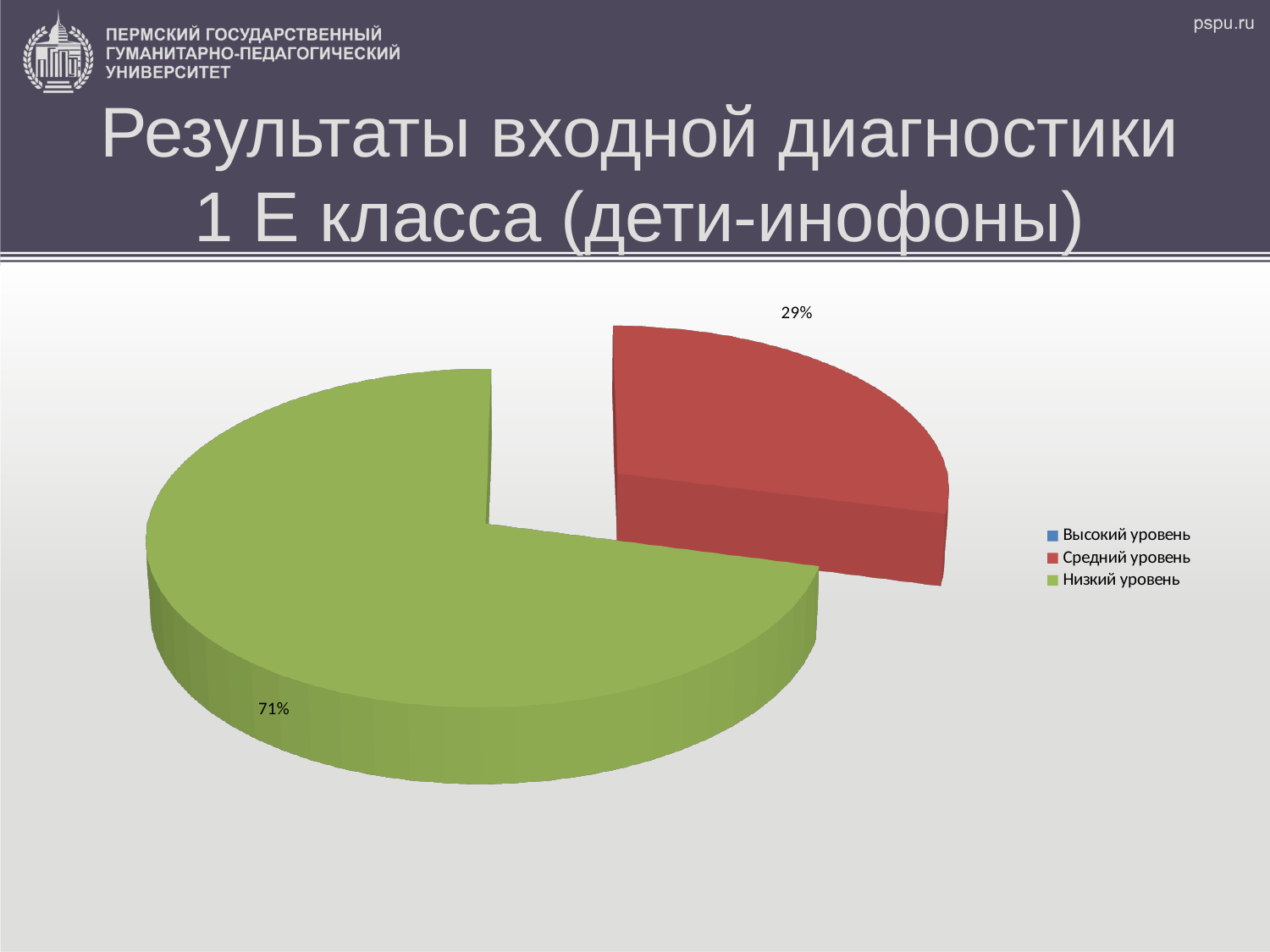
What colour is the slice for Низкий уровень? green What colour is the slice for Средний уровень? red Is the share for Низкий уровень greater or less than 50%? greater What share of the pie does Средний уровень have? 29% Which is larger, the slice for Средний уровень or the slice for Низкий уровень? Низкий уровень Which category has the largest slice of the pie? Низкий уровень What share of the pie does Низкий уровень have? 71% How many entries does the legend list? 3 What is the difference in percentage points between the Низкий уровень slice and the Средний уровень slice? 42 What kind of chart is shown on the slide? pie chart How many slices of the pie have a percentage label printed on the chart? 2 Is the share for Средний уровень greater or less than 50%? less